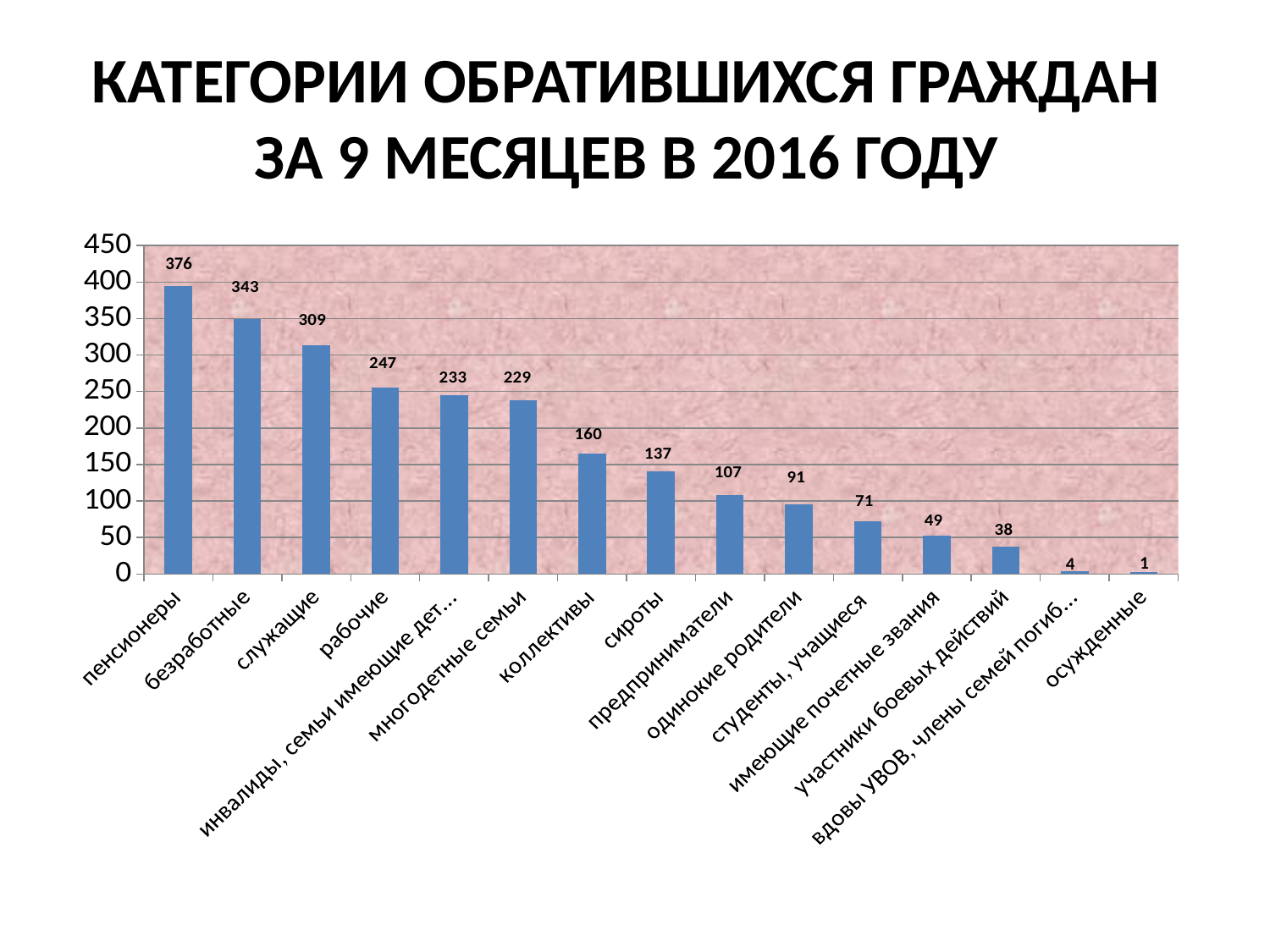
What is the difference between the values for безработные and служащие? 34 What is the value for пенсионеры? 376 Is the value for многодетные семьи greater or less than 200? greater Do the values rise or fall from left to right along the x axis? fall What is the difference between the values for рабочие and сироты? 110 Which category has the lowest value? осужденные Which is larger, the value for предприниматели or the value for студенты, учащиеся? предприниматели What is the value for одинокие родители? 91 What is the value for коллективы? 160 Which category has the highest value? пенсионеры What kind of chart is shown on the slide? bar chart How many categories are shown on the x axis? 15